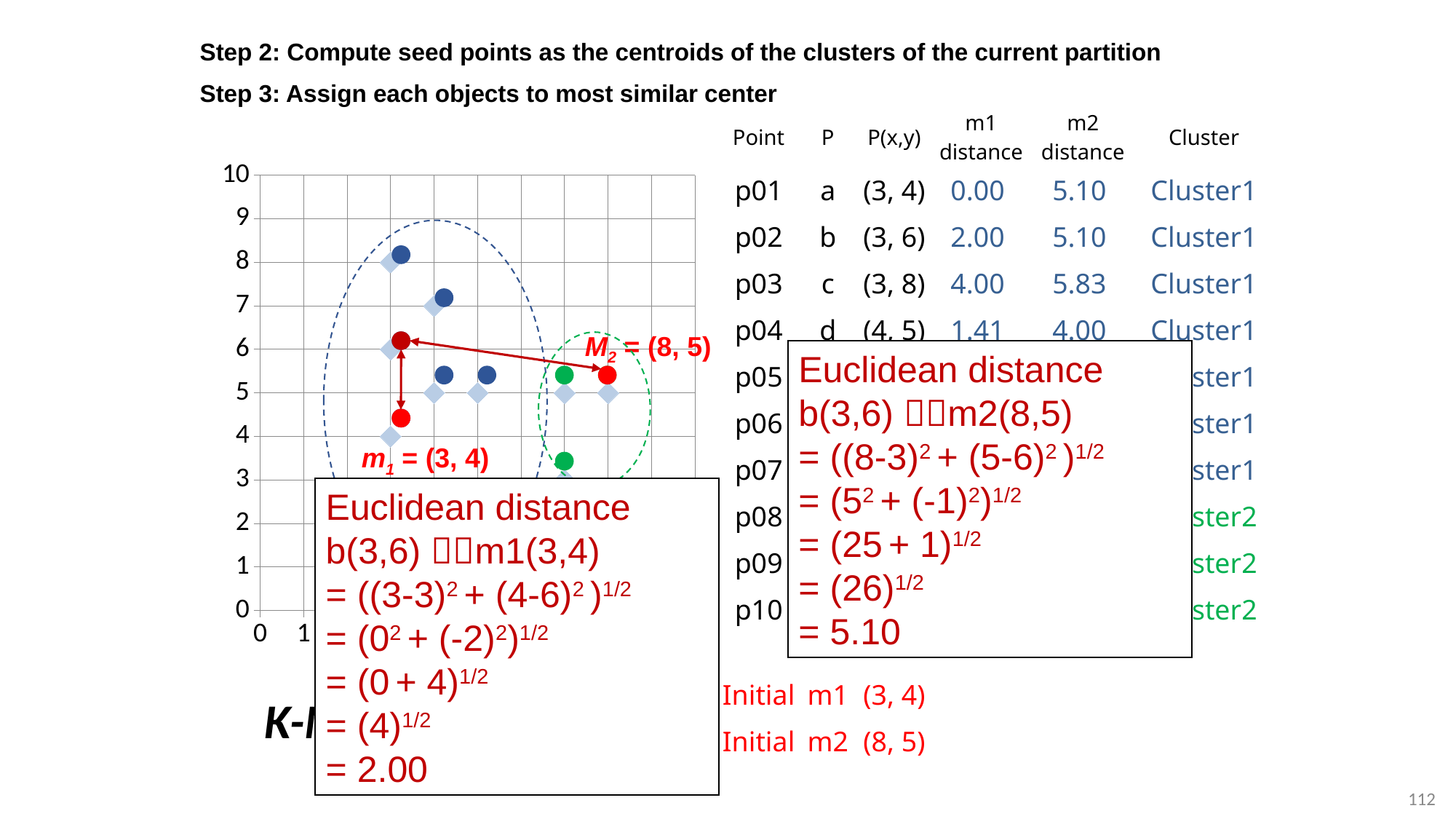
What is the difference between the y coordinates of M2 and m1? 1 Which centroid has the larger x coordinate, m1 or M2? M2 Is the y value of the centroid M2 greater or less than 4? greater What kind of chart is shown on the slide? scatter chart Is the y value of the centroid m1 greater or less than 5? less What coordinates are labeled for the centroid m1 on the chart? (3, 4) What colour are the centroid points m1 and M2 drawn in on the chart? red What coordinates are labeled for the centroid M2 on the chart? (8, 5) What is the highest tick value shown on the y axis of the chart? 10 What is the difference between the x coordinates of M2 and m1? 5